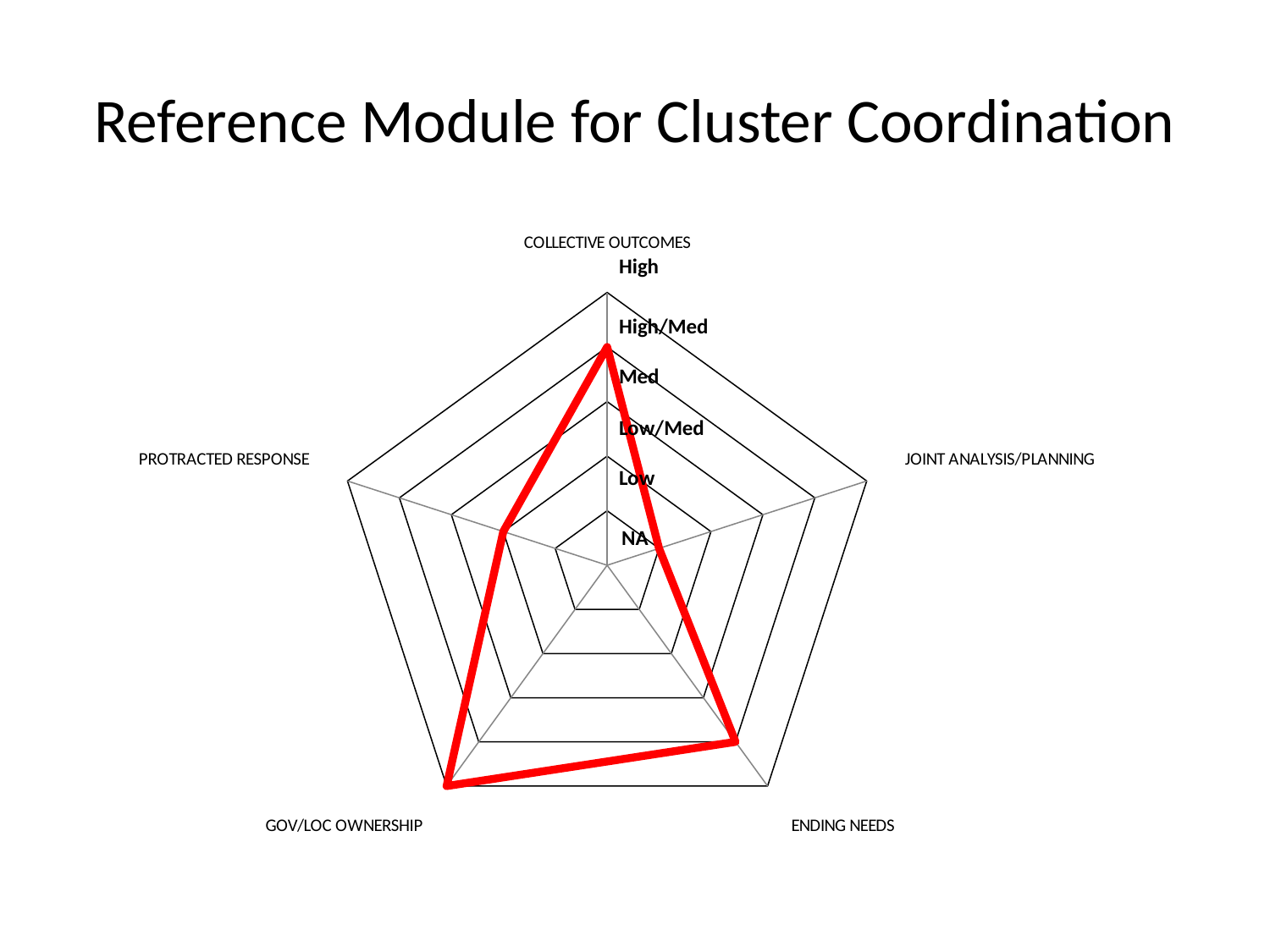
How many axes (categories) does the radar chart have? 5 What kind of chart is shown on the slide? Radar chart Which category has the lowest level on the chart? JOINT ANALYSIS/PLANNING Which is rated higher, COLLECTIVE OUTCOMES or PROTRACTED RESPONSE? COLLECTIVE OUTCOMES What level does the chart show for ENDING NEEDS? High/Med Which category has the highest level on the chart? GOV/LOC OWNERSHIP What level does the chart show for JOINT ANALYSIS/PLANNING? Low What is the highest level label on the chart's scale? High What level does the chart show for GOV/LOC OWNERSHIP? High What level does the chart show for COLLECTIVE OUTCOMES? High/Med What level does the chart show for PROTRACTED RESPONSE? Low/Med What is the title of the slide containing the chart? Reference Module for Cluster Coordination